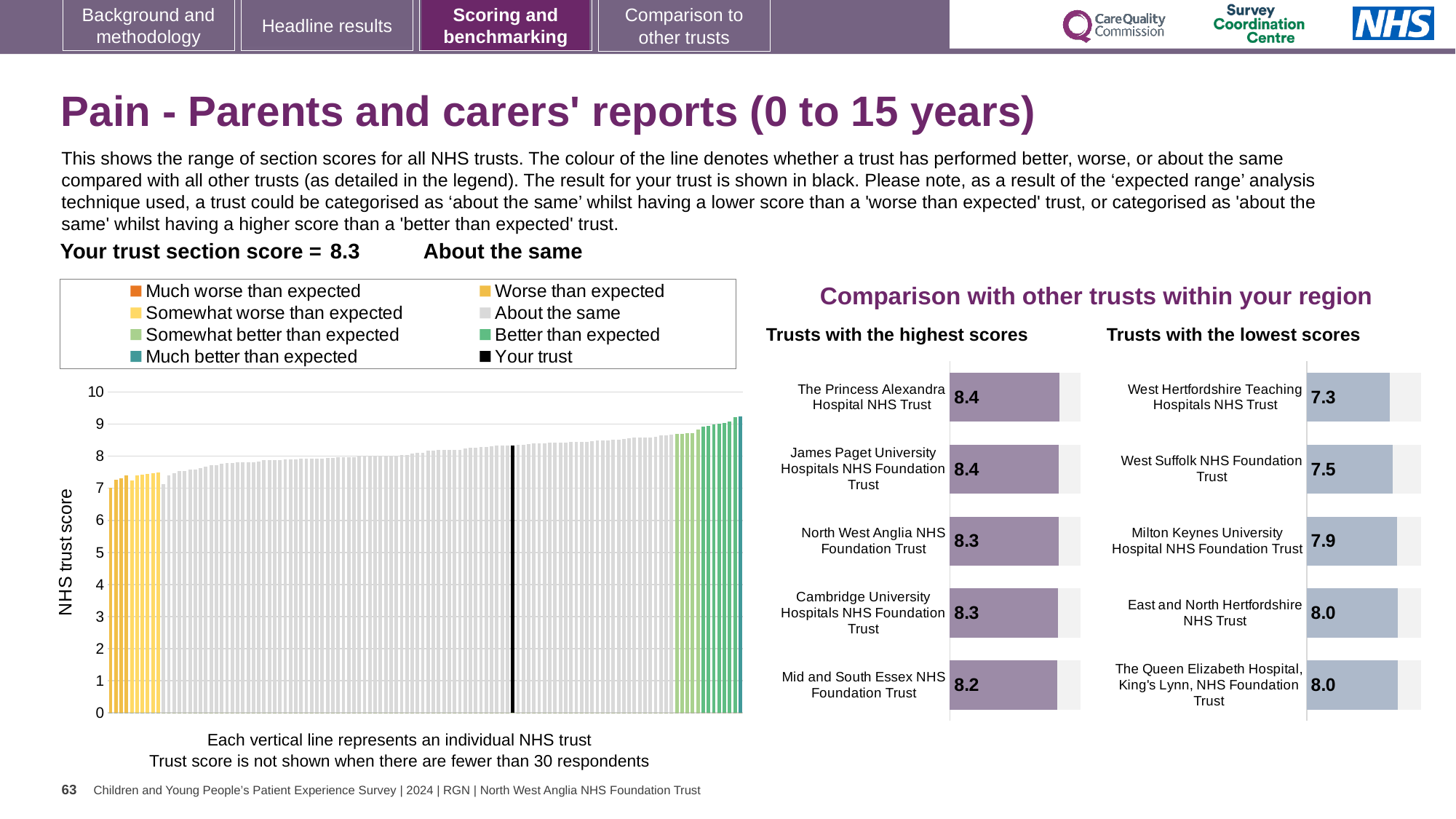
What kind of chart is the large chart on the left showing NHS trust scores? Bar chart In the 'Trusts with the highest scores' chart, what is the score for Mid and South Essex NHS Foundation Trust? 8.2 In the 'Trusts with the highest scores' chart, what is the score for The Princess Alexandra Hospital NHS Trust? 8.4 In the 'Trusts with the lowest scores' chart, which trust has the lowest score? West Hertfordshire Teaching Hospitals NHS Trust How many trusts are shown in the 'Trusts with the highest scores' chart? 5 In the 'Trusts with the lowest scores' chart, what is the difference between the scores of Milton Keynes University Hospital NHS Foundation Trust and West Hertfordshire Teaching Hospitals NHS Trust? 0.6 In the 'Trusts with the lowest scores' chart, what is the score for Milton Keynes University Hospital NHS Foundation Trust? 7.9 In the 'Trusts with the lowest scores' chart, what is the score for West Hertfordshire Teaching Hospitals NHS Trust? 7.3 In the large chart on the left, do the trust scores rise or fall from left to right along the x axis? Rise In the 'Trusts with the lowest scores' chart, which has the larger score: West Suffolk NHS Foundation Trust or Milton Keynes University Hospital NHS Foundation Trust? Milton Keynes University Hospital NHS Foundation Trust In the large chart on the left, is the value for 'Your trust' greater or less than 8? greater In the 'Trusts with the highest scores' chart, which trust has the lowest score? Mid and South Essex NHS Foundation Trust